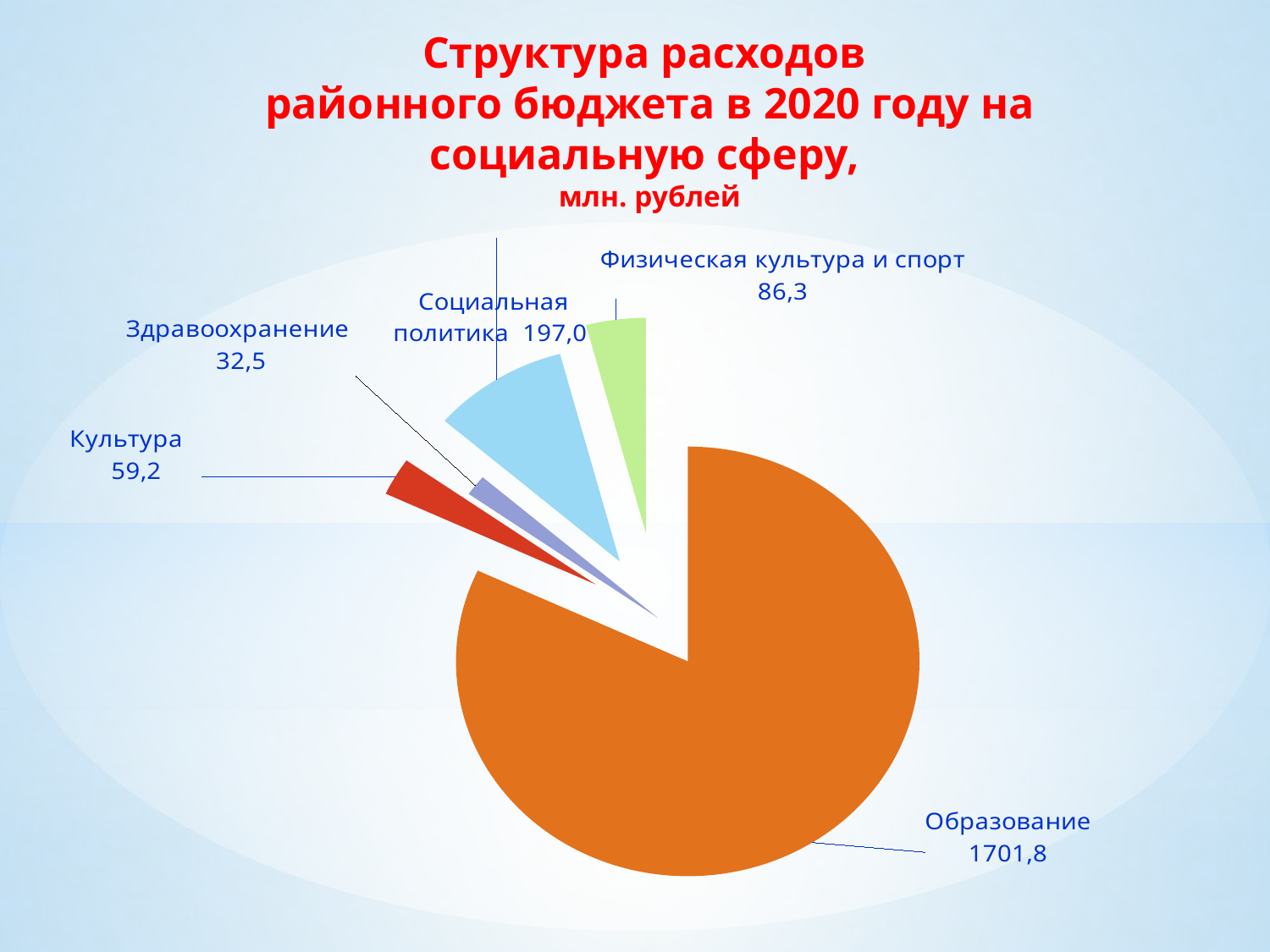
What is the value for Образование? 1701,8 What type of chart is shown on the slide? pie chart How many slices does the pie chart have? 5 What is the value for Социальная политика? 197,0 What is the difference between the values for Культура and Здравоохранение? 26,7 Which category has the largest slice of the pie? Образование What is the value for Здравоохранение? 32,5 What is the difference between the values for Социальная политика and Физическая культура и спорт? 110,7 What is the value for Физическая культура и спорт? 86,3 In what units are the values on the chart given, according to the title? млн. рублей Which category has the smallest slice of the pie? Здравоохранение Which is larger, the value for Культура or the value for Физическая культура и спорт? Физическая культура и спорт